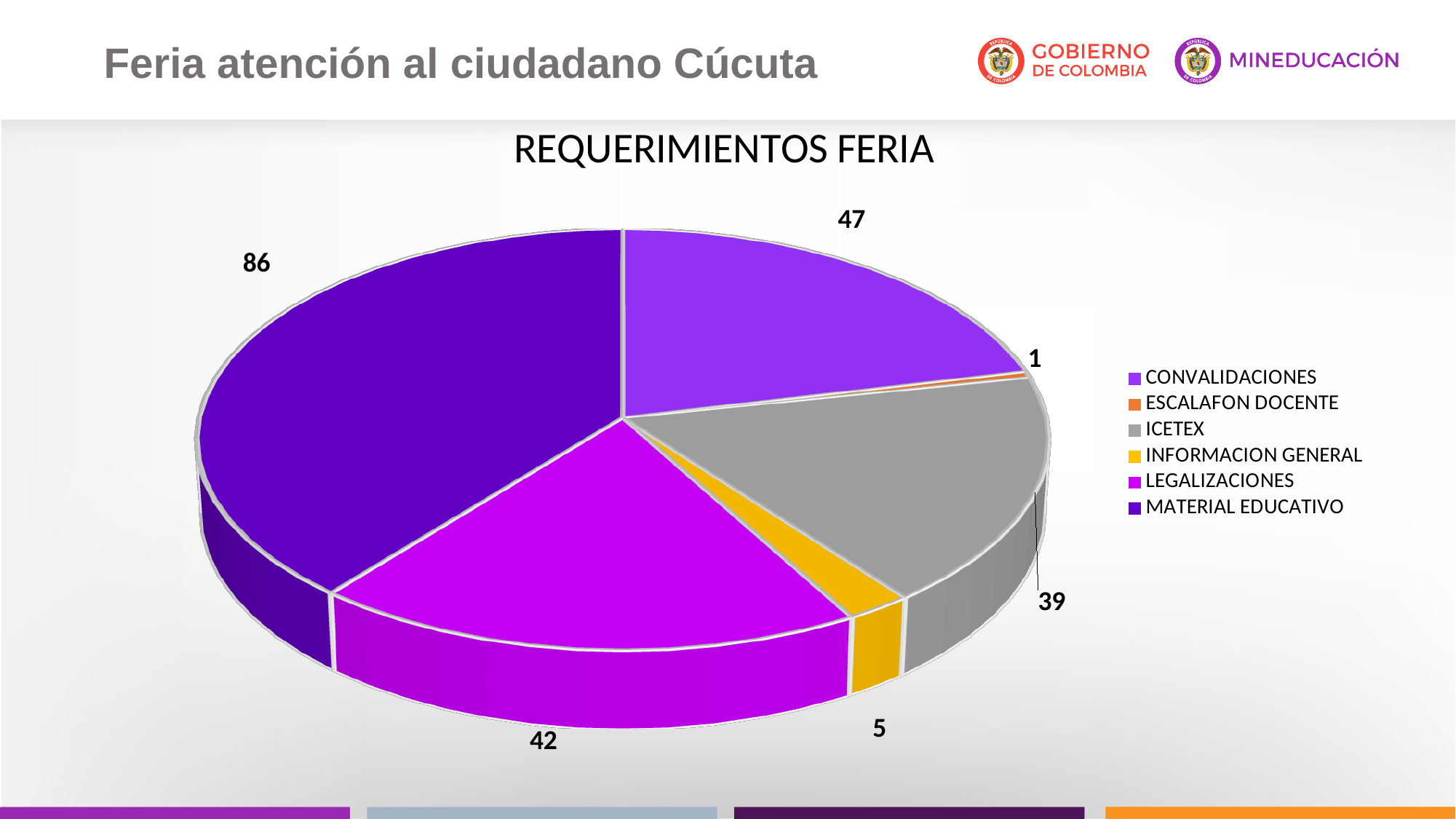
Which category has the highest value? MATERIAL EDUCATIVO What is the value for ICETEX? 39 What type of chart is shown on the slide? pie chart What is the title of the chart? REQUERIMIENTOS FERIA Which is larger, the value for CONVALIDACIONES or the value for ICETEX? CONVALIDACIONES Which category has the lowest value? ESCALAFON DOCENTE What is the value for MATERIAL EDUCATIVO? 86 What is the difference between the values for MATERIAL EDUCATIVO and LEGALIZACIONES? 44 What is the total of all the slices in the pie chart? 220 How many categories does the pie chart have? 6 What is the value for INFORMACION GENERAL? 5 What is the value for CONVALIDACIONES? 47